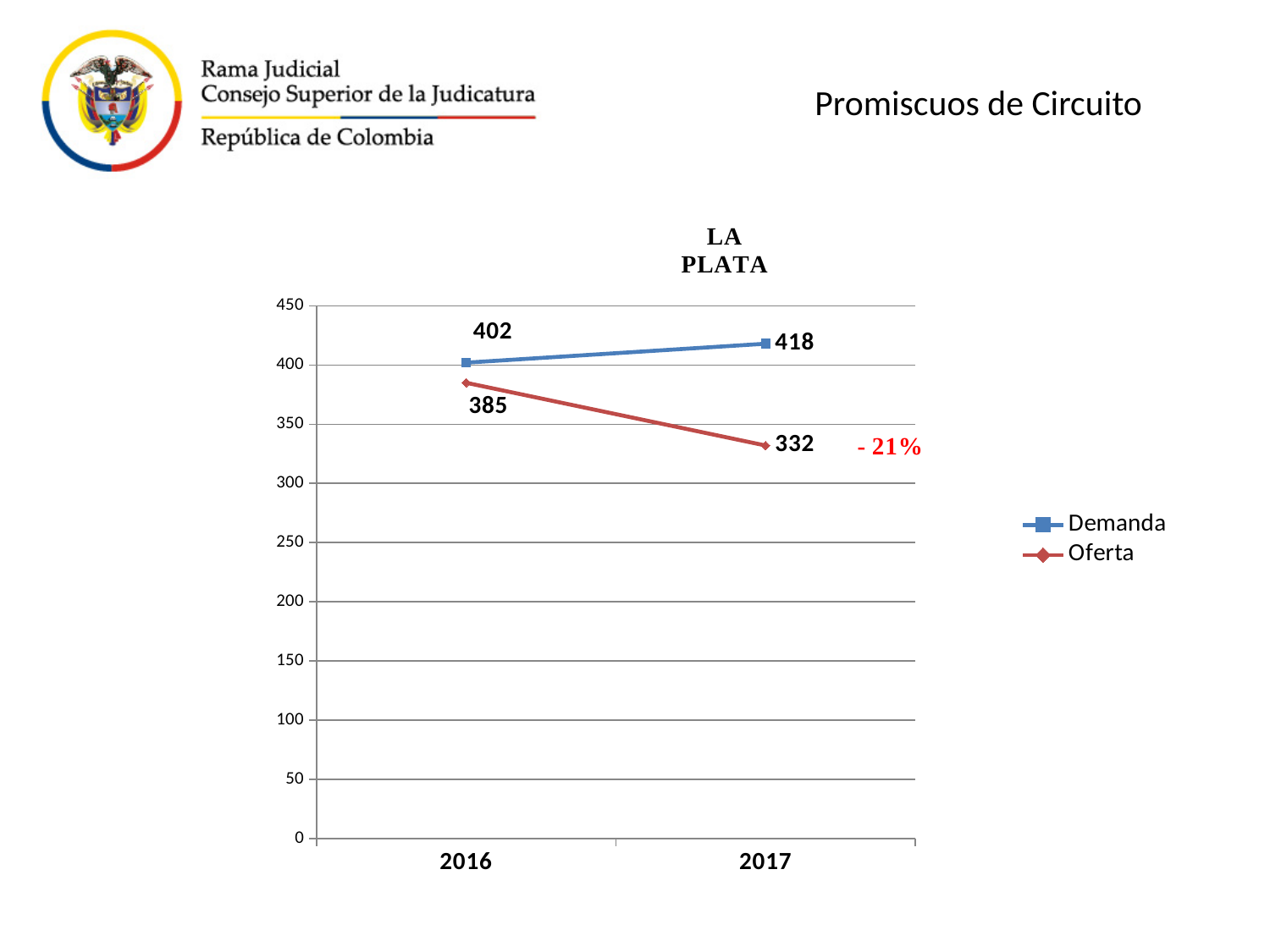
By how much did Oferta change from 2016 to 2017? 53 Which series has the higher value in 2016, Demanda or Oferta? Demanda What is the value of Demanda in 2017? 418 What is the value of Oferta in 2016? 385 What is the value of Demanda in 2016? 402 What kind of chart is shown? line chart Does the Oferta series rise or fall from 2016 to 2017? fall What percentage change is annotated in red next to the Oferta line? - 21% Does the Demanda series rise or fall from 2016 to 2017? rise What is the difference between Demanda and Oferta in 2017? 86 How many series does the legend list? 2 What is the value of Oferta in 2017? 332